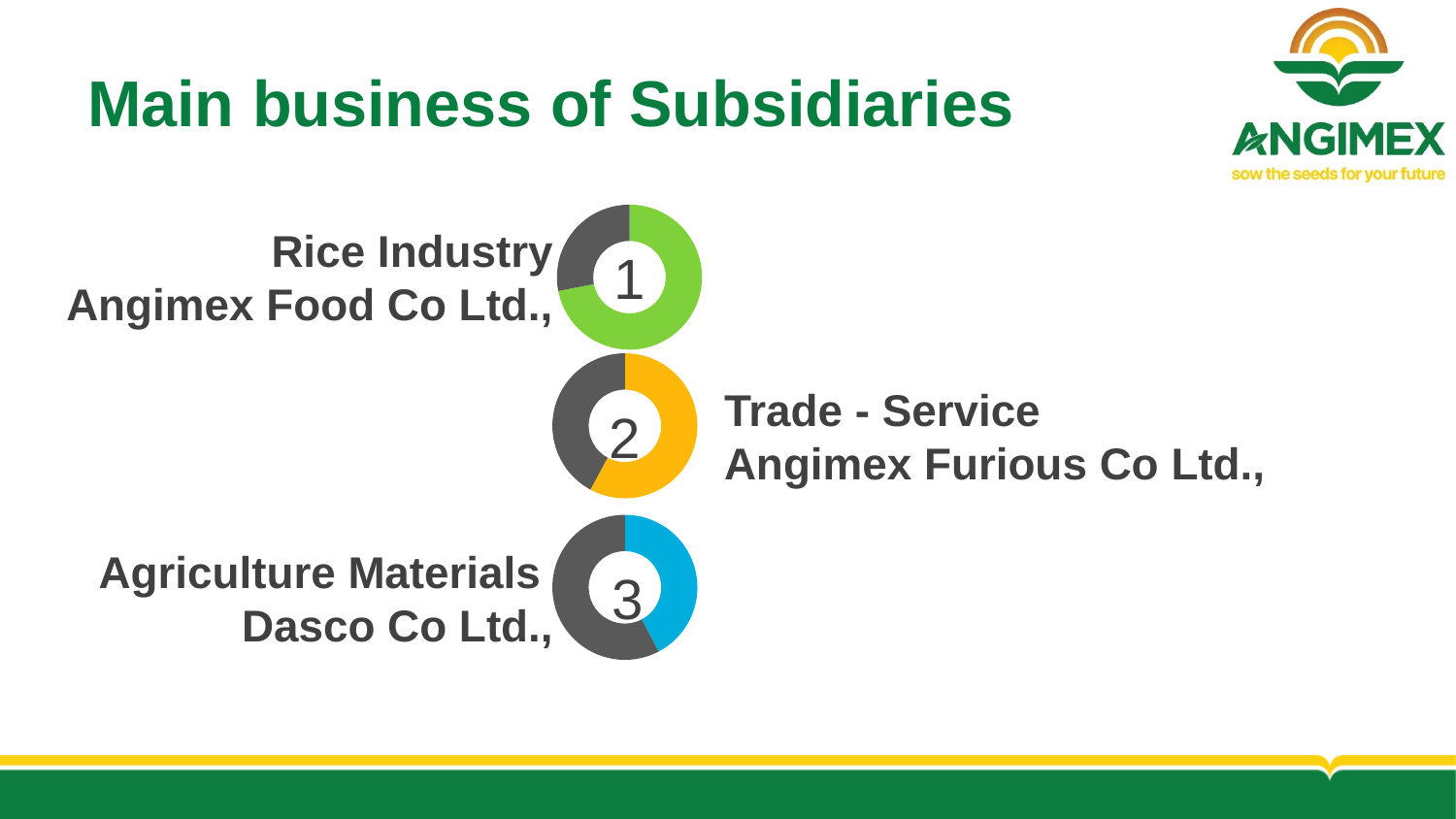
In the doughnut chart numbered 3, which segment is larger, the blue one or the grey one? grey In the doughnut chart numbered 1, which segment is larger, the green one or the grey one? green Which business is labelled next to the doughnut chart numbered 2? Trade - Service How many doughnut charts are on the slide? 3 Which subsidiary is labelled next to the doughnut chart numbered 3? Dasco Co Ltd., What kind of chart is used for the three numbered graphics on the slide? doughnut chart In the doughnut chart numbered 2, which segment is larger, the orange one or the grey one? orange